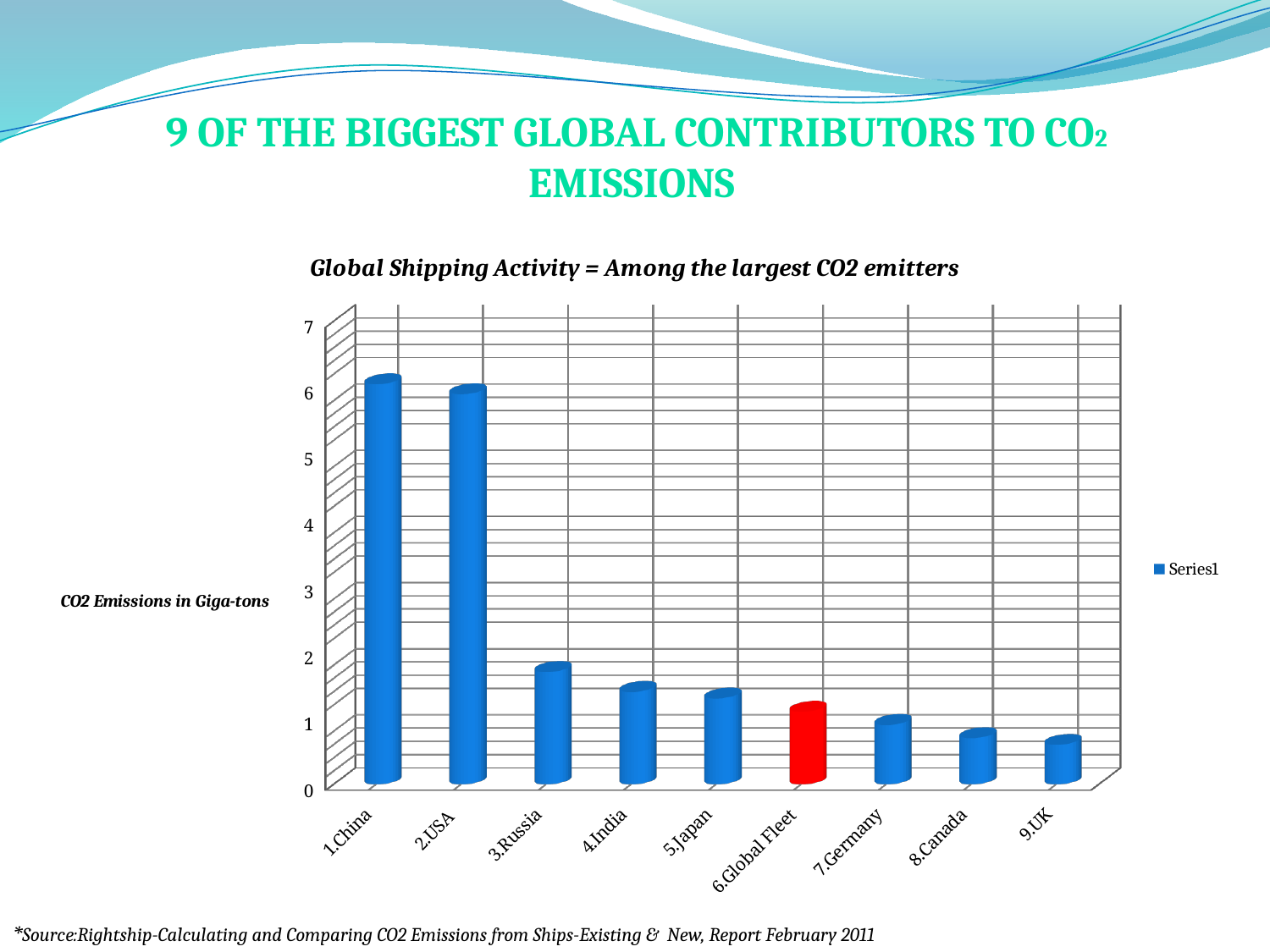
Which is larger, the value for 5.Japan or the value for 7.Germany? 5.Japan How many series does the legend list? 1 Is the value for 8.Canada greater or less than 1? less What kind of chart is shown on the slide? Bar chart Which is larger, the value for 3.Russia or the value for 4.India? 3.Russia Is the value for 1.China greater or less than 5? greater How many categories are plotted on the chart? 9 Do the values rise or fall moving from left to right along the x axis? fall Which category has the highest CO2 emissions on the chart? 1.China Which category's bar is coloured red? 6.Global Fleet Is the value for 3.Russia greater or less than 2? less Which category has the lowest CO2 emissions on the chart? 9.UK